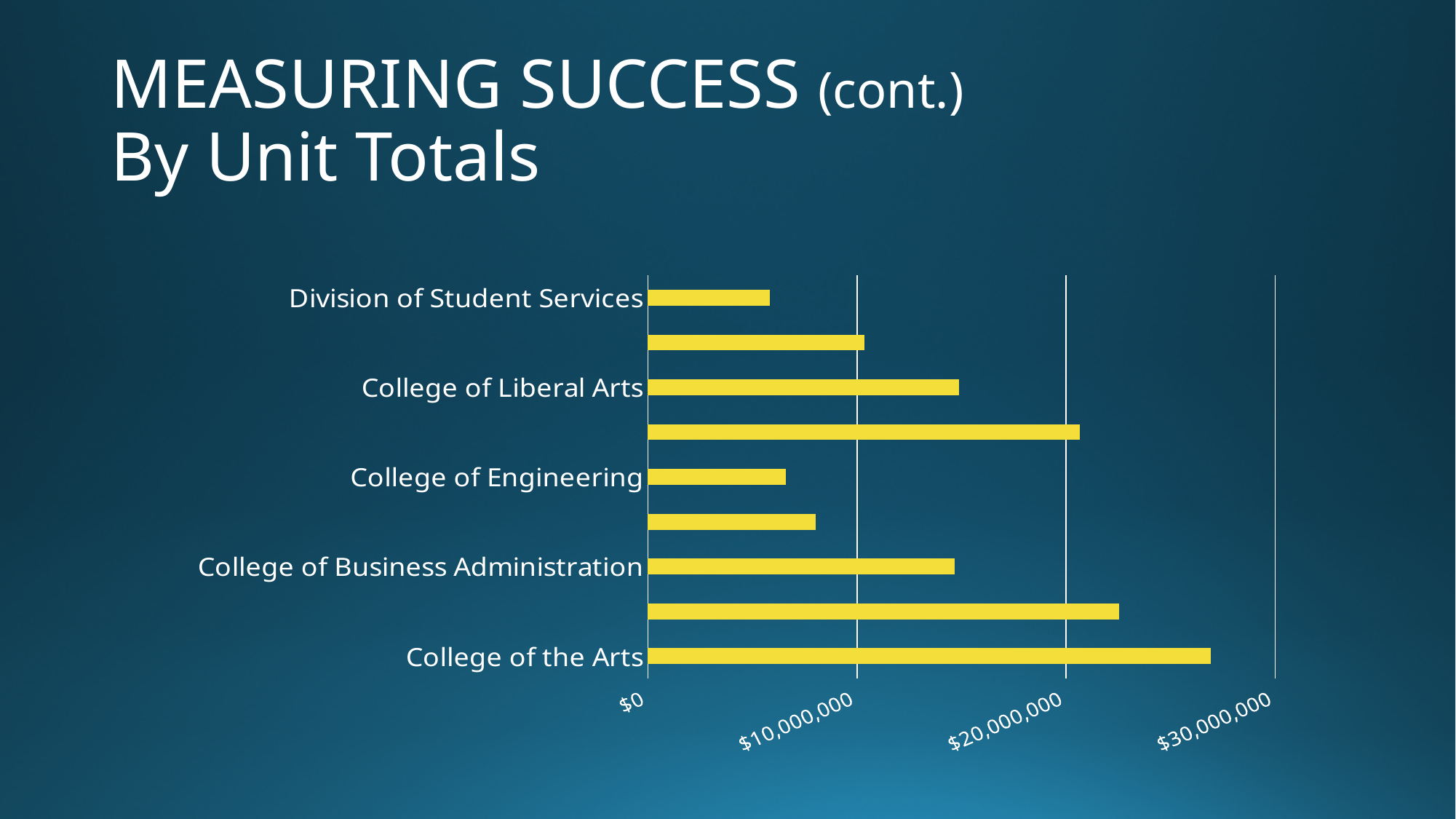
Is the value for College of Liberal Arts greater or less than $10,000,000? greater Is the value for College of Engineering greater or less than $10,000,000? less What is the highest value labeled on the horizontal axis? $30,000,000 Which is larger, the value for College of the Arts or the value for College of Liberal Arts? College of the Arts Is the value for College of Liberal Arts greater or less than $20,000,000? less What kind of chart is shown on the slide? bar chart How many bars are plotted in the chart? 9 Which labeled unit has the longest bar? College of the Arts Which is larger, the value for College of Liberal Arts or the value for College of Engineering? College of Liberal Arts